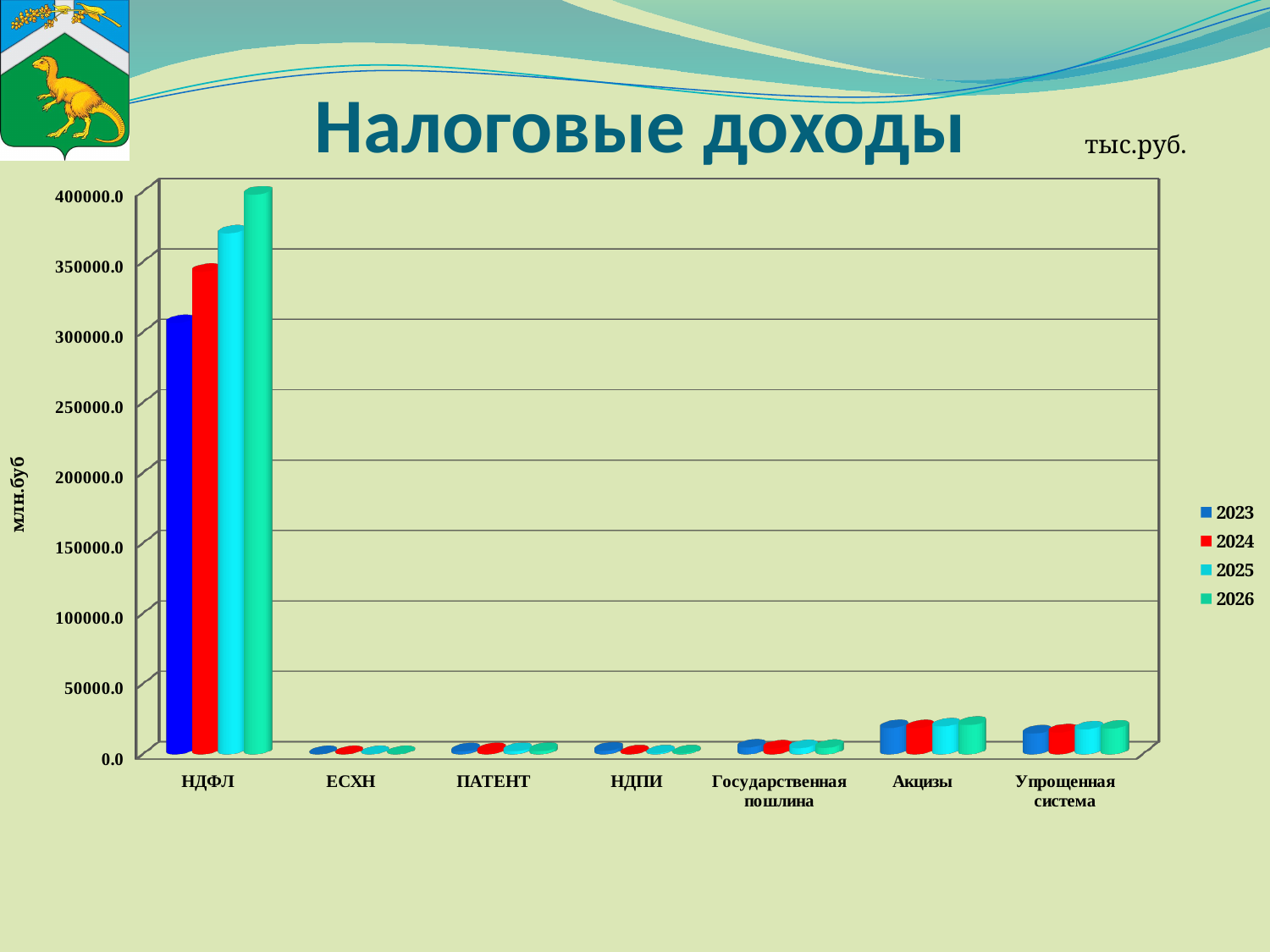
Is the value for Акцизы in 2026 greater or less than 50000.0? less What is the title of the chart on the slide? Налоговые доходы How many series does the legend list? 4 How many categories are shown on the x axis of the chart? 7 Is the value for НДФЛ in 2025 greater or less than 350000.0? greater Which category has the larger value in 2025: Акцизы or ЕСХН? Акцизы Do the values for НДФЛ rise or fall from 2023 to 2026? rise Which category has the highest values in the chart? НДФЛ Is the value for ЕСХН in 2024 greater or less than 50000.0? less What kind of chart is shown on the slide? bar chart Which is larger for НДФЛ: the value for 2023 or the value for 2026? 2026